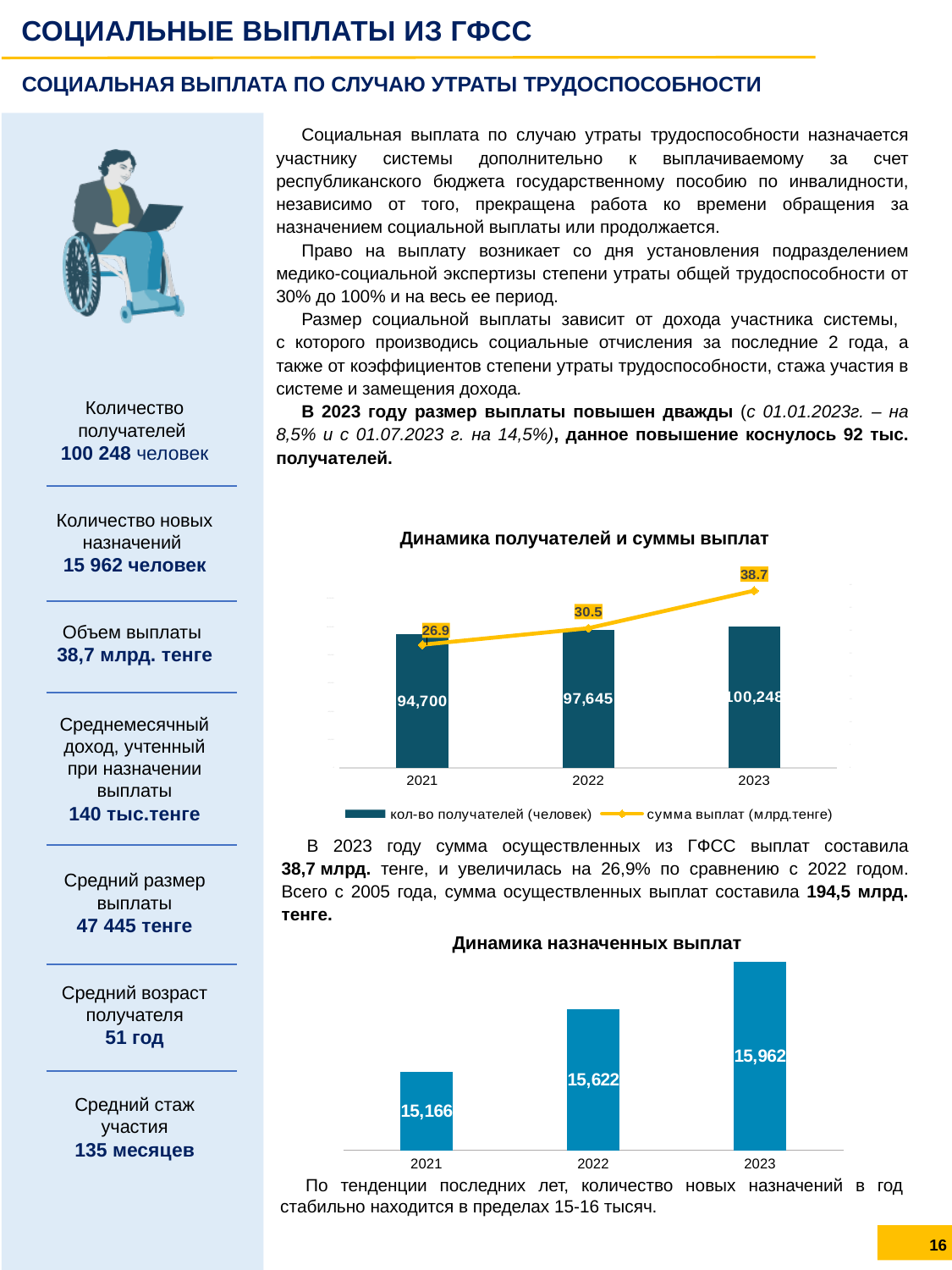
In the chart 'Динамика получателей и суммы выплат', what is the сумма выплат value for 2021? 26.9 In the chart 'Динамика получателей и суммы выплат', what is the number of recipients (кол-во получателей) in 2022? 97,645 In the chart 'Динамика получателей и суммы выплат', by how much did the number of recipients increase from 2021 to 2023? 5,548 In the chart 'Динамика получателей и суммы выплат', how many series does the legend list? 2 In the chart 'Динамика получателей и суммы выплат', which year has the highest number of recipients? 2023 In the chart 'Динамика назначенных выплат', how many years are shown on the x axis? 3 In the chart 'Динамика получателей и суммы выплат', does the сумма выплат line rise or fall from 2021 to 2023? rise In the chart 'Динамика назначенных выплат', what is the difference between the 2023 and 2022 values? 340 In the chart 'Динамика назначенных выплат', what is the value for 2021? 15,166 What type of chart is 'Динамика назначенных выплат'? bar chart In the chart 'Динамика получателей и суммы выплат', what is the сумма выплат value for 2023? 38.7 In the chart 'Динамика назначенных выплат', which year has the lowest value? 2021